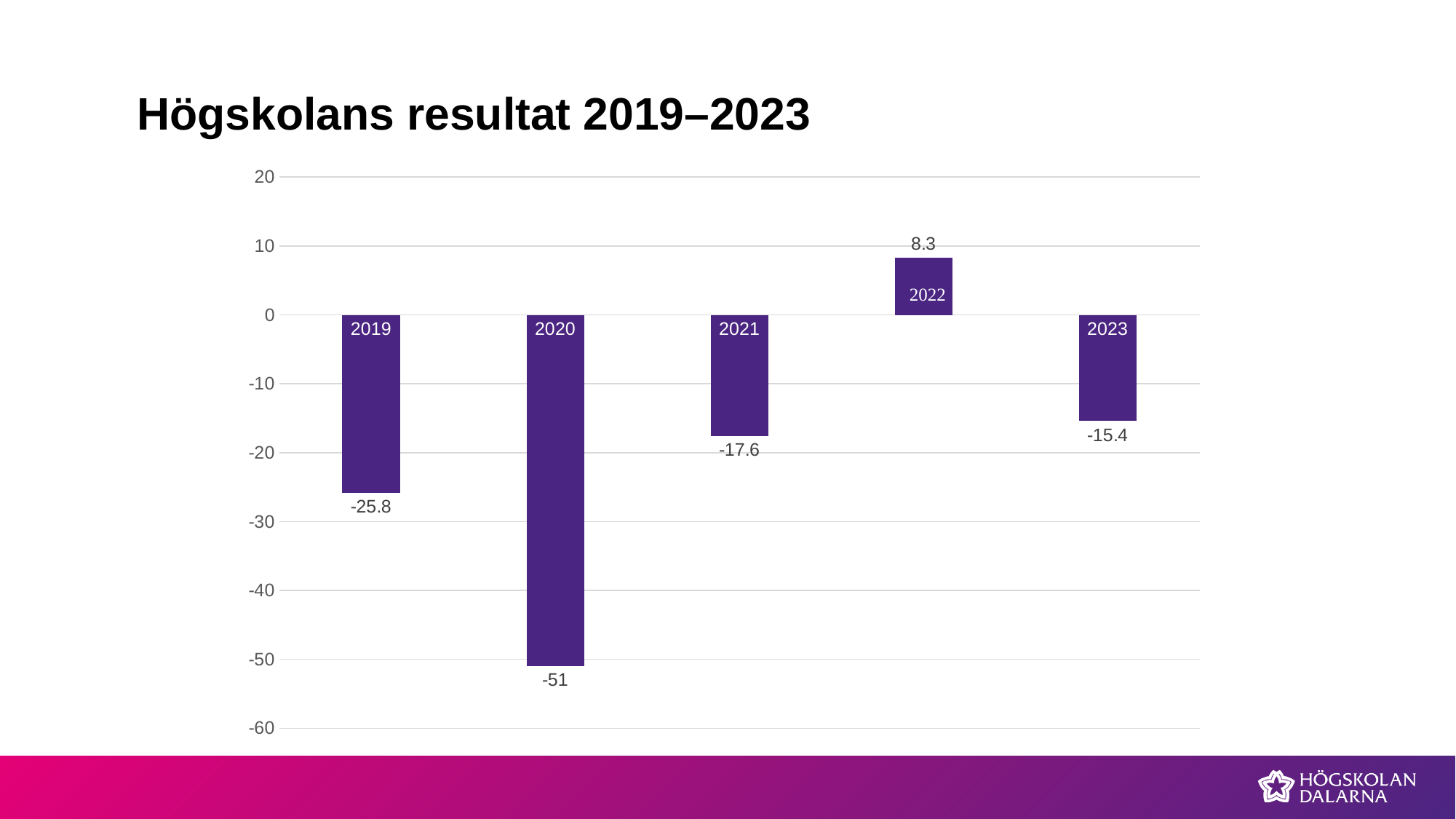
What is the value for 2019? -25.8 Which year has the lowest value? 2020 What is the value for 2022? 8.3 Is the value for 2020 greater or less than -40? less Which year has the highest value? 2022 Which is larger, the value for 2019 or the value for 2021? 2021 What is the value for 2020? -51 What kind of chart is shown on the slide? Bar chart How many years are shown in the chart? 5 What is the difference between the values for 2021 and 2023? 2.2 What is the value for 2023? -15.4 What is the title of the slide? Högskolans resultat 2019–2023